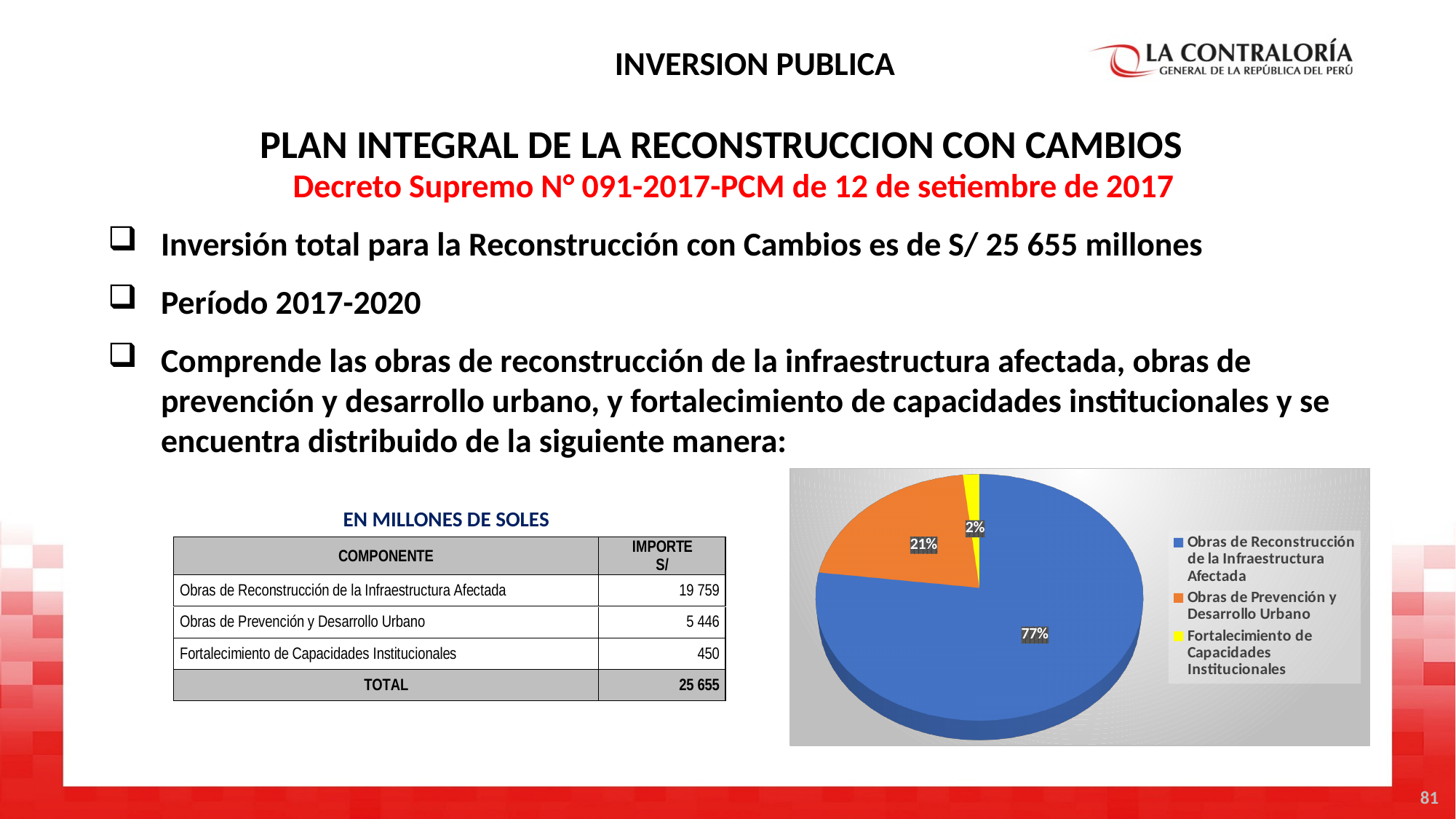
Which is larger in the pie chart: Obras de Prevención y Desarrollo Urbano or Fortalecimiento de Capacidades Institucionales? Obras de Prevención y Desarrollo Urbano How many entries does the legend of the pie chart list? 3 What share of the pie does Obras de Reconstrucción de la Infraestructura Afectada represent? 77% Which category has the largest slice of the pie? Obras de Reconstrucción de la Infraestructura Afectada How many categories does the pie chart show? 3 What kind of chart is shown on the slide? Pie chart What share of the pie does Obras de Prevención y Desarrollo Urbano represent? 21% What share of the pie does Fortalecimiento de Capacidades Institucionales represent? 2% Which category has the smallest slice of the pie? Fortalecimiento de Capacidades Institucionales What is the difference in percentage points between the 77% slice and the 21% slice? 56 What colour is the slice for Obras de Prevención y Desarrollo Urbano in the pie chart? Orange What colour is the slice for Fortalecimiento de Capacidades Institucionales in the pie chart? Yellow